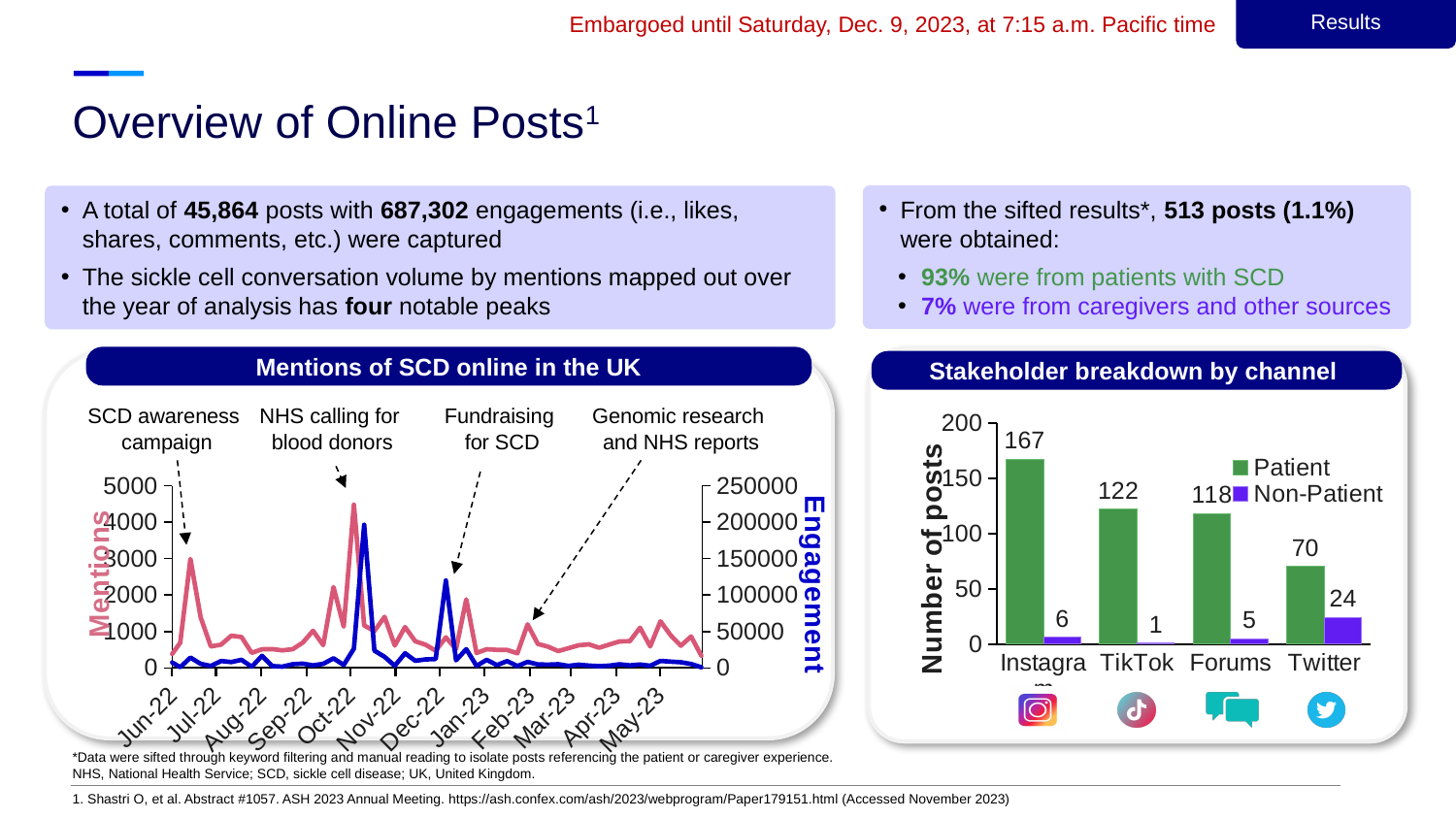
In the 'Stakeholder breakdown by channel' chart, how many Patient posts are shown for Instagram? 167 In the 'Stakeholder breakdown by channel' chart, which channel has the lowest number of Non-Patient posts? TikTok In the 'Stakeholder breakdown by channel' chart, how many channels are shown on the x axis? 4 What kind of chart is 'Mentions of SCD online in the UK'? Line chart In the 'Stakeholder breakdown by channel' chart, how many Non-Patient posts are shown for Twitter? 24 In the 'Stakeholder breakdown by channel' chart, which has more Patient posts, Forums or Twitter? Forums In the 'Stakeholder breakdown by channel' chart, what is the difference between Patient and Non-Patient posts on Twitter? 46 What kind of chart is 'Stakeholder breakdown by channel'? Bar chart In the 'Mentions of SCD online in the UK' chart, what is the label of the right-hand vertical axis? Engagement In the 'Mentions of SCD online in the UK' chart, is the peak value of Mentions around Oct-22 greater or less than 4000? greater In the 'Stakeholder breakdown by channel' chart, which channel has the highest number of Patient posts? Instagram In the 'Stakeholder breakdown by channel' chart, how many series does the legend list? 2